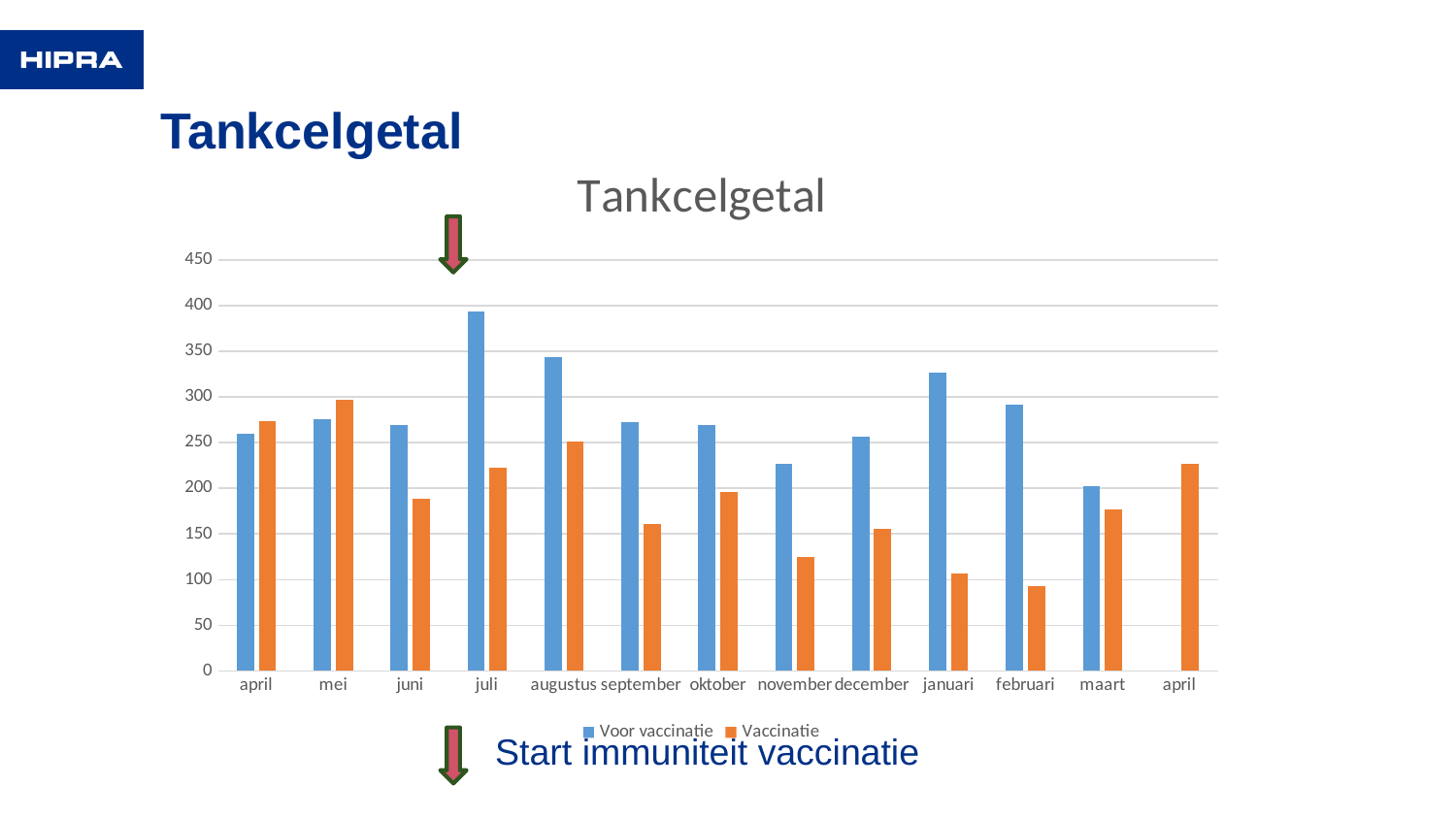
In which month is the Voor vaccinatie value highest? juli How many month categories are shown on the x axis? 13 What kind of chart is shown on the slide? bar chart What is the title of the chart? Tankcelgetal Is the Voor vaccinatie value for juli greater or less than 350? greater Is the Voor vaccinatie value for januari greater or less than 300? greater In januari, which series has the larger value, Voor vaccinatie or Vaccinatie? Voor vaccinatie How many series does the legend list? 2 Is the Vaccinatie value for november greater or less than 150? less In which month is the Vaccinatie value lowest? februari In which month is the Vaccinatie value highest? mei In mei, which series has the larger value, Voor vaccinatie or Vaccinatie? Vaccinatie